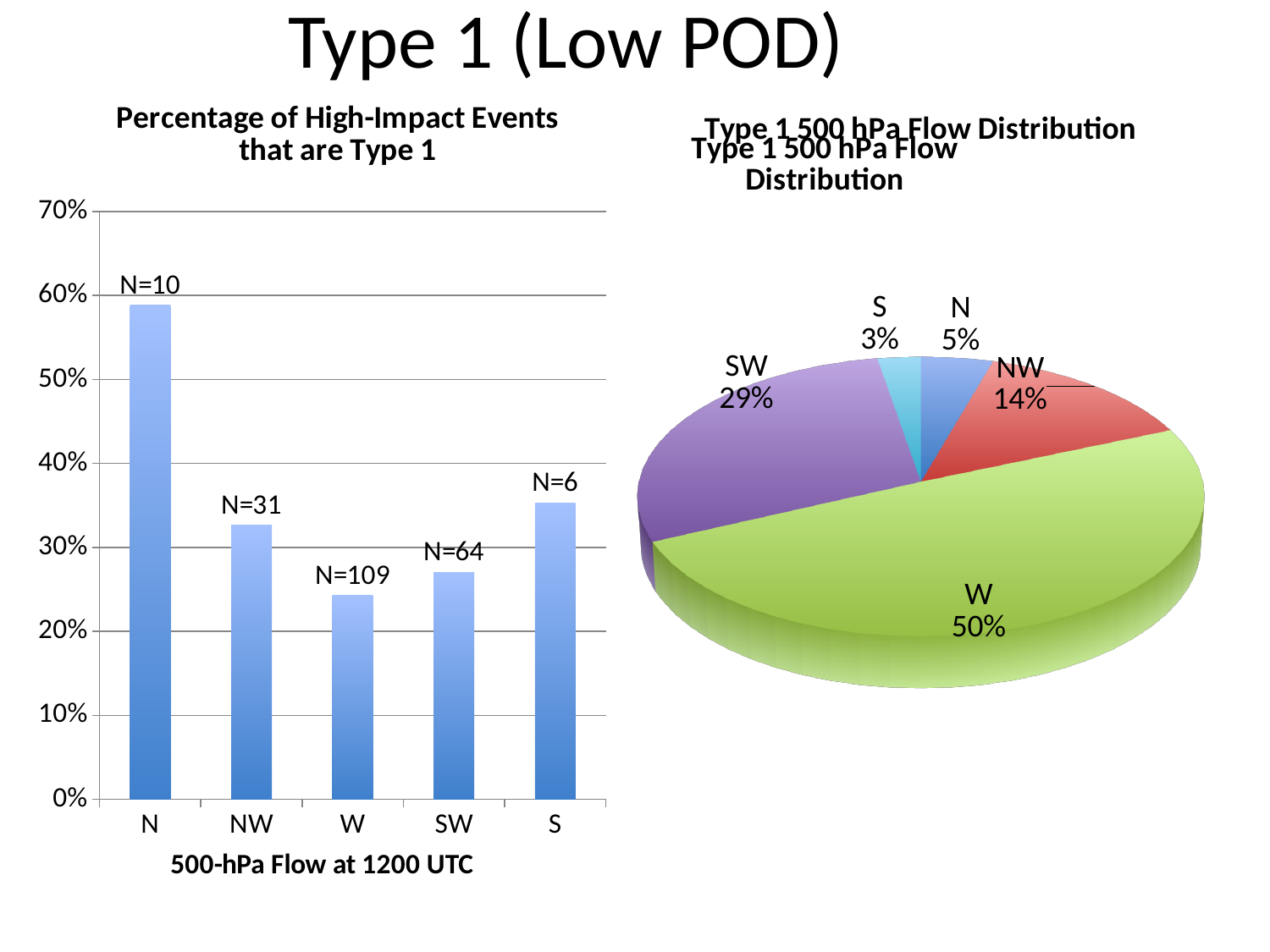
In the left bar chart, which is larger, the value for S or the value for SW? S In the left bar chart, which flow direction has the highest percentage? N In the right pie chart, what is the difference between the SW share and the NW share? 15% In the left bar chart, which flow direction has the lowest percentage? W In the right pie chart, what share does W have? 50% In the left bar chart, what is the N label shown above the W bar? N=109 In the left bar chart, is the value for N greater or less than 50%? greater What kind of chart is the right chart, 'Type 1 500 hPa Flow Distribution'? pie chart In the left bar chart, is the value for W greater or less than 30%? less What kind of chart is the left chart, 'Percentage of High-Impact Events that are Type 1'? bar chart In the right pie chart, which flow direction has the smallest slice? S How many flow-direction categories are shown on the x axis of the left bar chart? 5